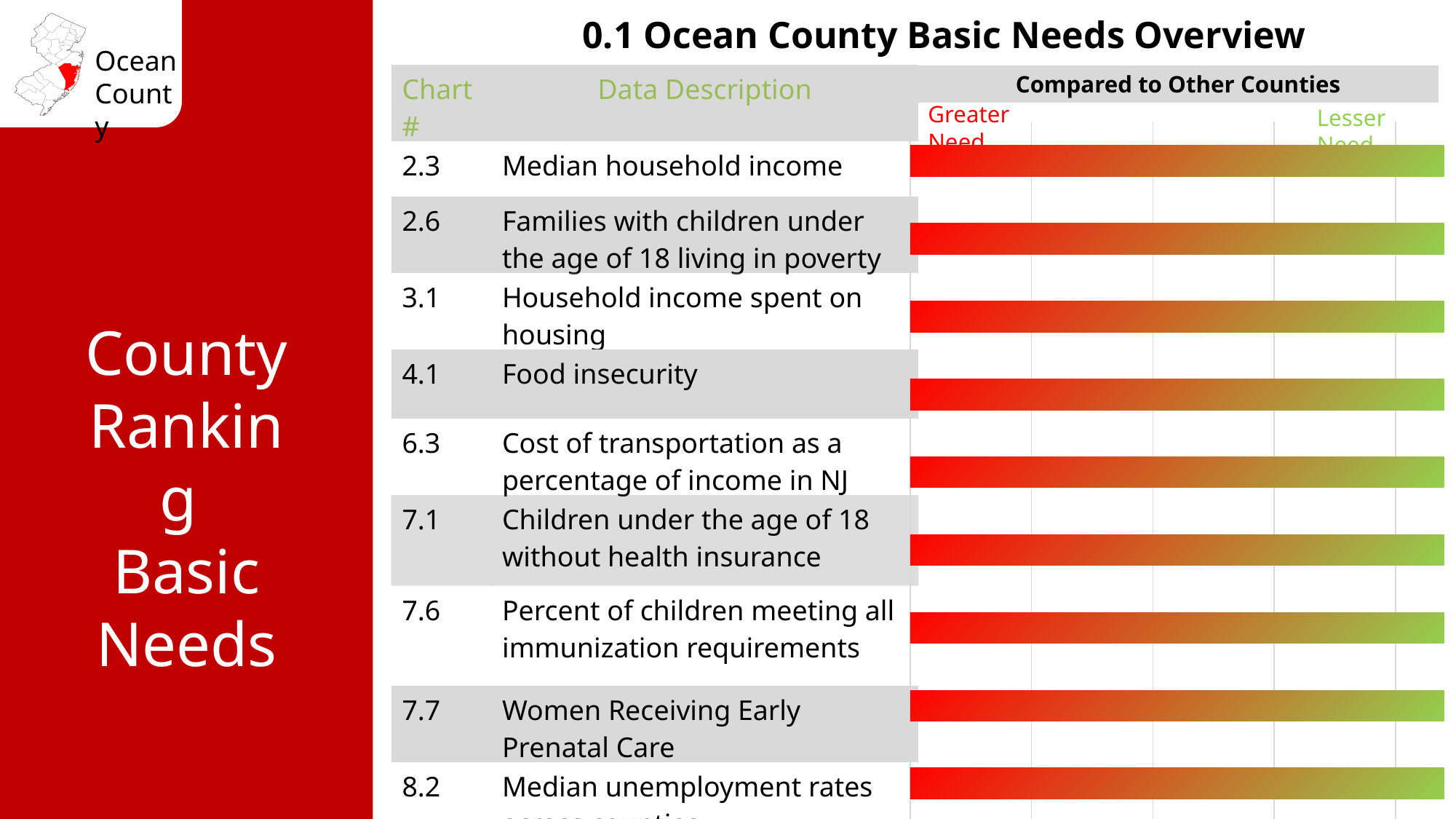
Which chart number is listed for Median household income? 2.3 Which chart number is listed for Food insecurity? 4.1 Which chart number is listed for Children under the age of 18 without health insurance? 7.1 Which data description is listed for chart number 7.7? Women Receiving Early Prenatal Care What kind of chart is shown on the slide? bar chart How many data description rows (bars) are shown in the chart? 9 Which data description is listed for chart number 8.2? Median unemployment rates Which chart number is listed for Household income spent on housing? 3.1 What is the title of the chart? 0.1 Ocean County Basic Needs Overview What label appears at the left end of the bar scale? Greater Need